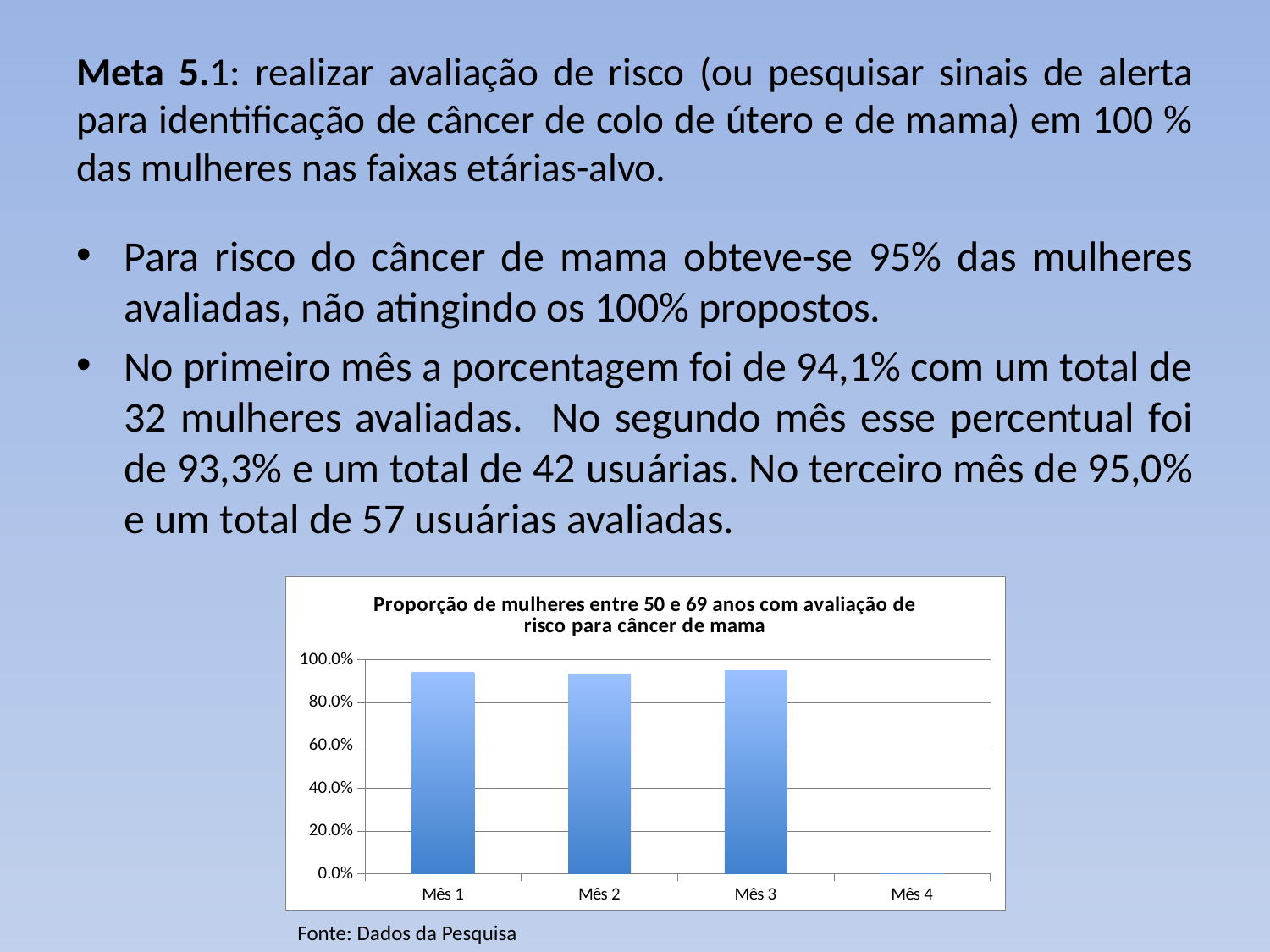
What kind of chart is shown on the slide? bar chart Which is larger, the value for Mês 1 or the value for Mês 4? Mês 1 Is the value for Mês 3 greater or less than 100.0%? less What is the source cited below the chart? Fonte: Dados da Pesquisa Which month has the lowest value in the chart? Mês 4 Is the value for Mês 2 greater or less than 60.0%? greater Is the value for Mês 4 greater or less than 20.0%? less How many categories (months) are shown on the x axis of the chart? 4 Which is larger, the value for Mês 3 or the value for Mês 4? Mês 3 What is the title of the chart? Proporção de mulheres entre 50 e 69 anos com avaliação de risco para câncer de mama What is the value for Mês 4 in the chart? 0.0%